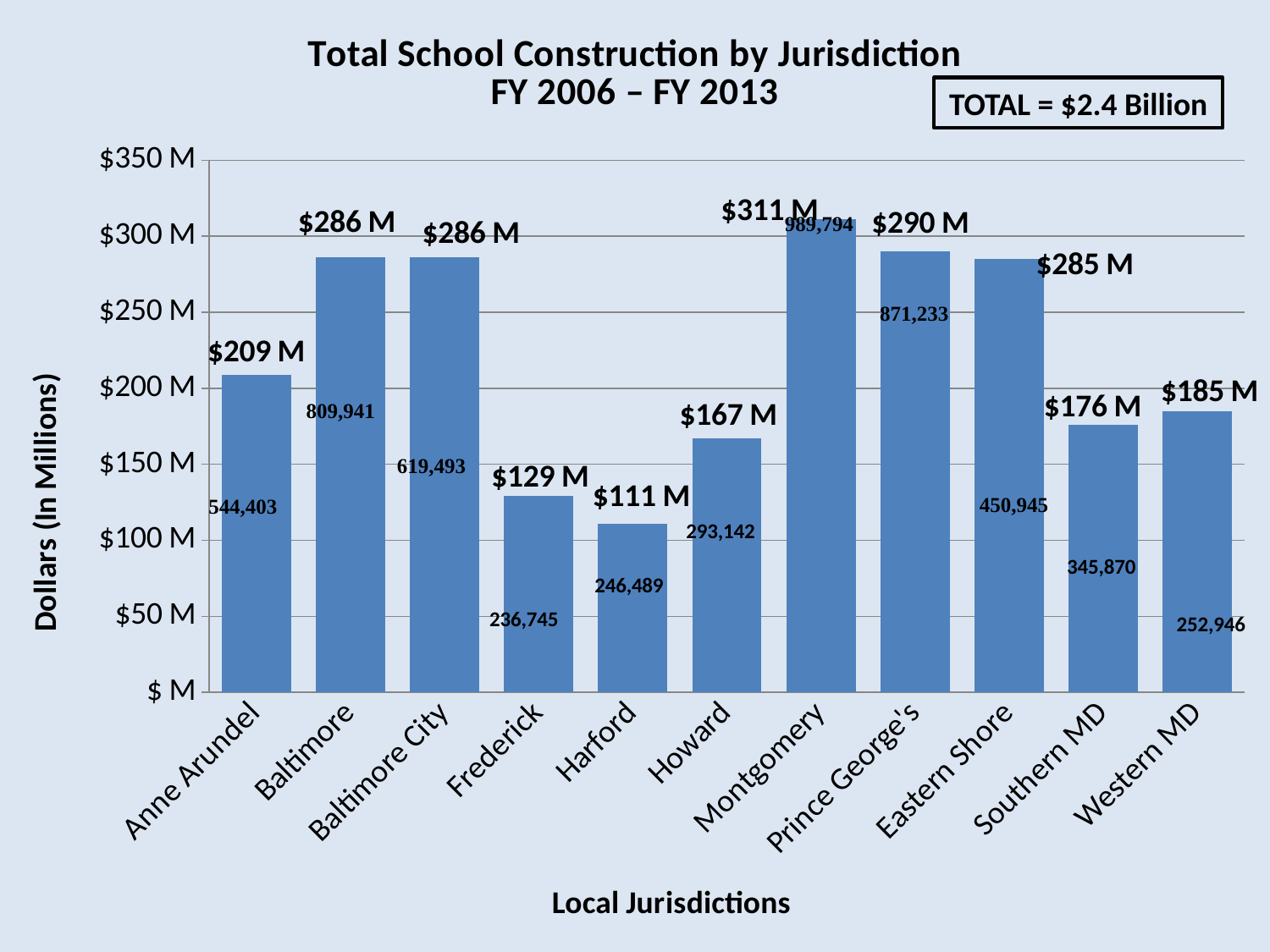
Which jurisdiction has the highest total school construction? Montgomery What kind of chart is this? Bar chart What is the value for Frederick? $129 M What is the value for Montgomery? $311 M What is the value for Western MD? $185 M What is the difference between the values for Anne Arundel and Howard? $42 M Which jurisdiction has the lowest total school construction? Harford Is the value for Howard greater or less than $150 M? greater What total is shown in the box at the top right of the slide? TOTAL = $2.4 Billion What is the difference between the values for Montgomery and Harford? $200 M Which is larger, the value for Prince George's or the value for Eastern Shore? Prince George's How many jurisdictions are shown on the x axis? 11